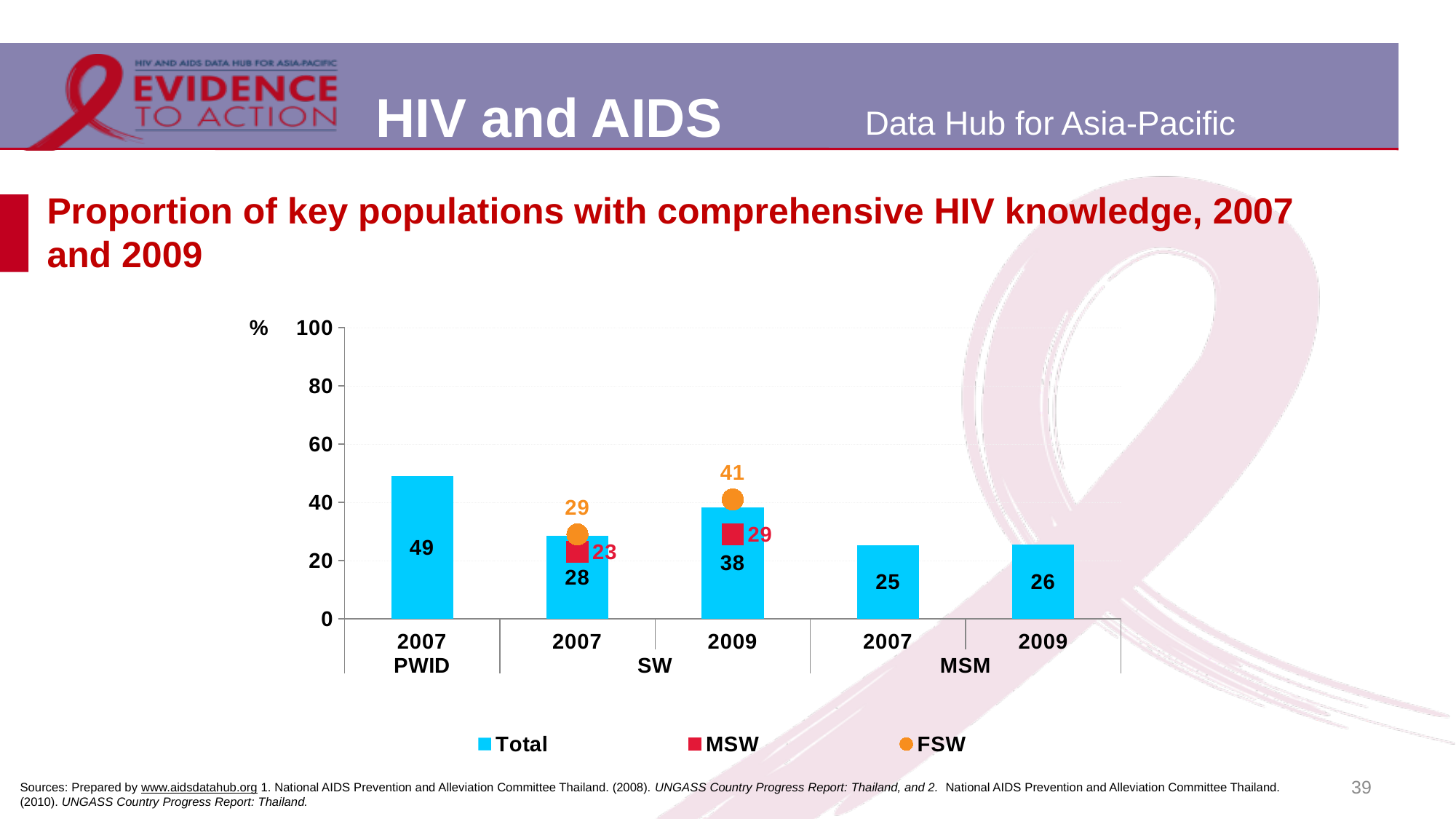
What is the FSW value for SW in 2009? 41 How many series does the legend list? 3 What is the difference between the Total value for SW in 2009 and SW in 2007? 10 Did the Total value for MSM rise or fall from 2007 to 2009? Rise What is the difference between the FSW value and the MSW value for SW in 2009? 12 Which group and year has the lowest Total value? MSM 2007 What is the Total value for PWID in 2007? 49 What is the Total value for SW in 2009? 38 What is the MSW value for SW in 2007? 23 Which group and year has the highest Total value? PWID 2007 What kind of chart is used to show the Total values? Bar chart Which is larger for SW in 2007: the FSW value or the MSW value? FSW